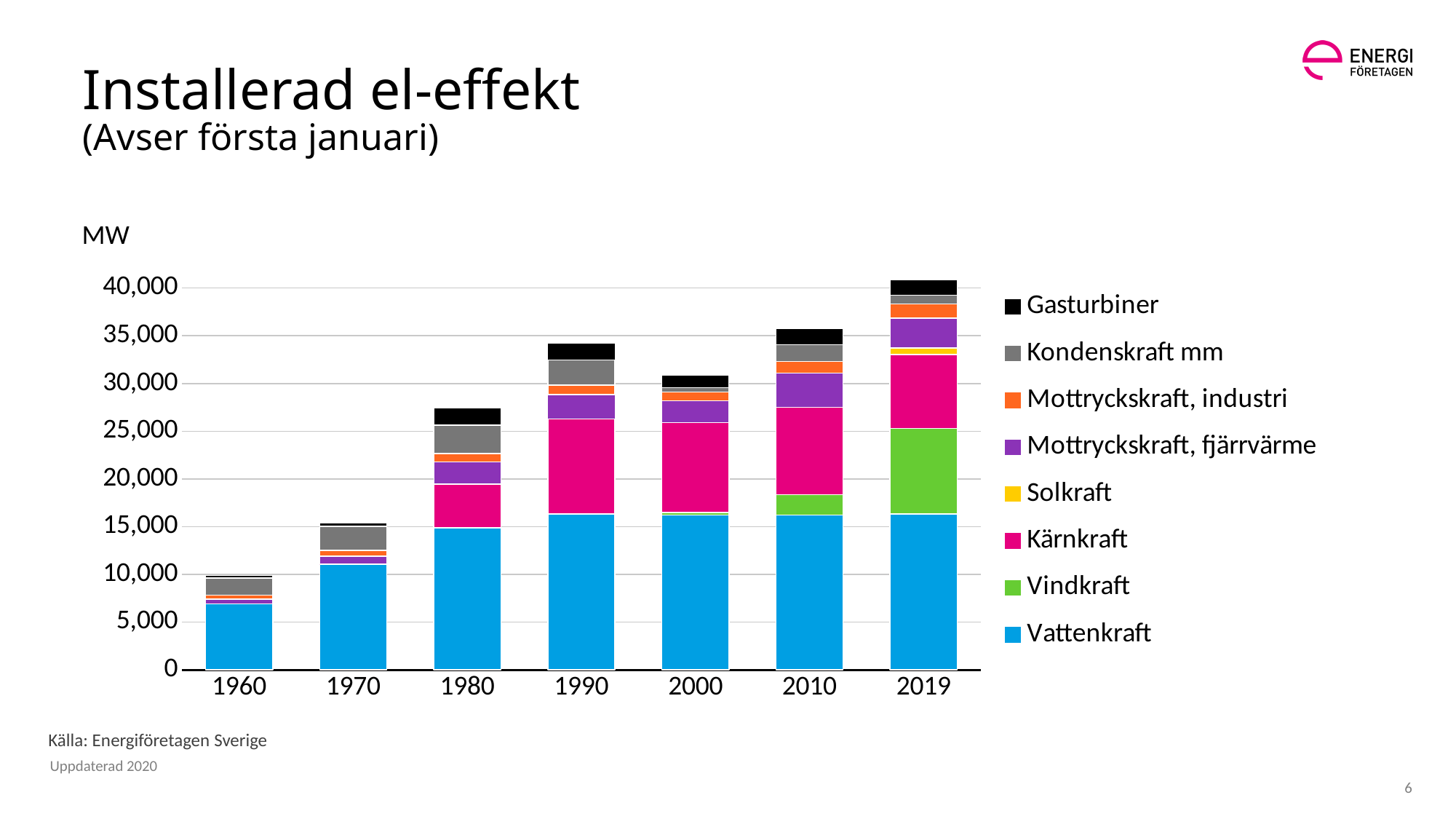
Is the total installed capacity for 1960 greater or less than 15,000 MW? less Which year has the highest total installed capacity in the chart? 2019 Which year has the lowest total installed capacity in the chart? 1960 Which series is shown at the bottom of each stacked bar? Vattenkraft How many series does the chart legend list? 8 How many years (bars) are shown on the x axis of the chart? 7 What kind of chart is shown on the slide? Stacked bar chart Is the total installed capacity for 2000 greater or less than 35,000 MW? less Which year has a larger total installed capacity, 1990 or 2000? 1990 Is the total installed capacity for 2019 greater or less than 35,000 MW? greater Does the total installed capacity rise or fall from 1960 to 1990? rise What unit is shown on the y axis of the chart? MW